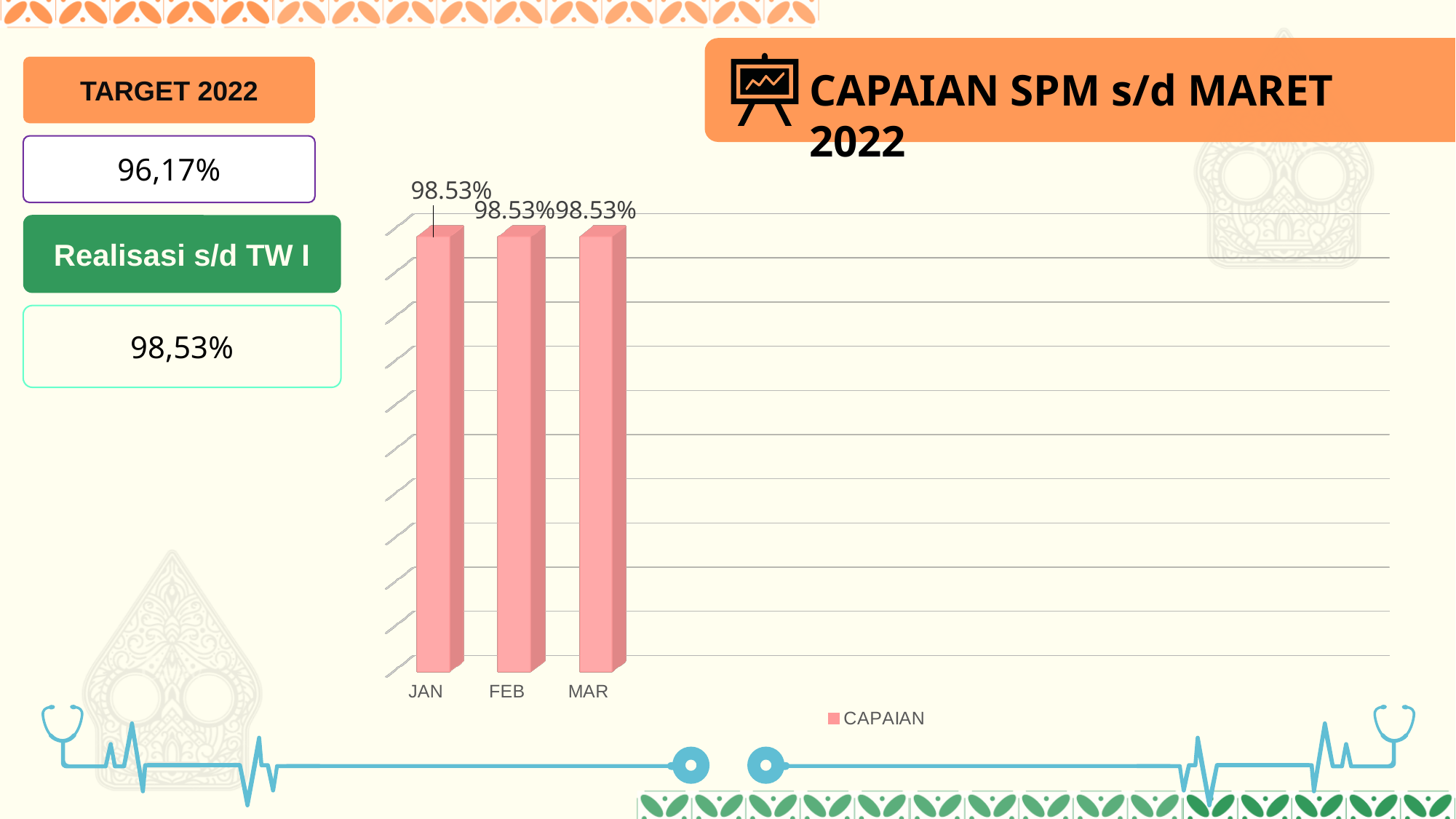
How many series does the chart legend list? 1 What is the value for MAR in the chart? 98.53% Is the value for FEB larger than, smaller than, or equal to the value for MAR? equal Do the values rise, fall, or stay the same from JAN to MAR? stay the same What is the value for JAN in the chart? 98.53% What is the difference between the values for JAN and MAR? 0.00% What is the title of the chart on the slide? CAPAIAN SPM s/d MARET 2022 How many months (categories) are plotted in the chart? 3 What is the value for FEB in the chart? 98.53% What is the name of the series shown in the chart legend? CAPAIAN What kind of chart is shown on the slide? bar chart